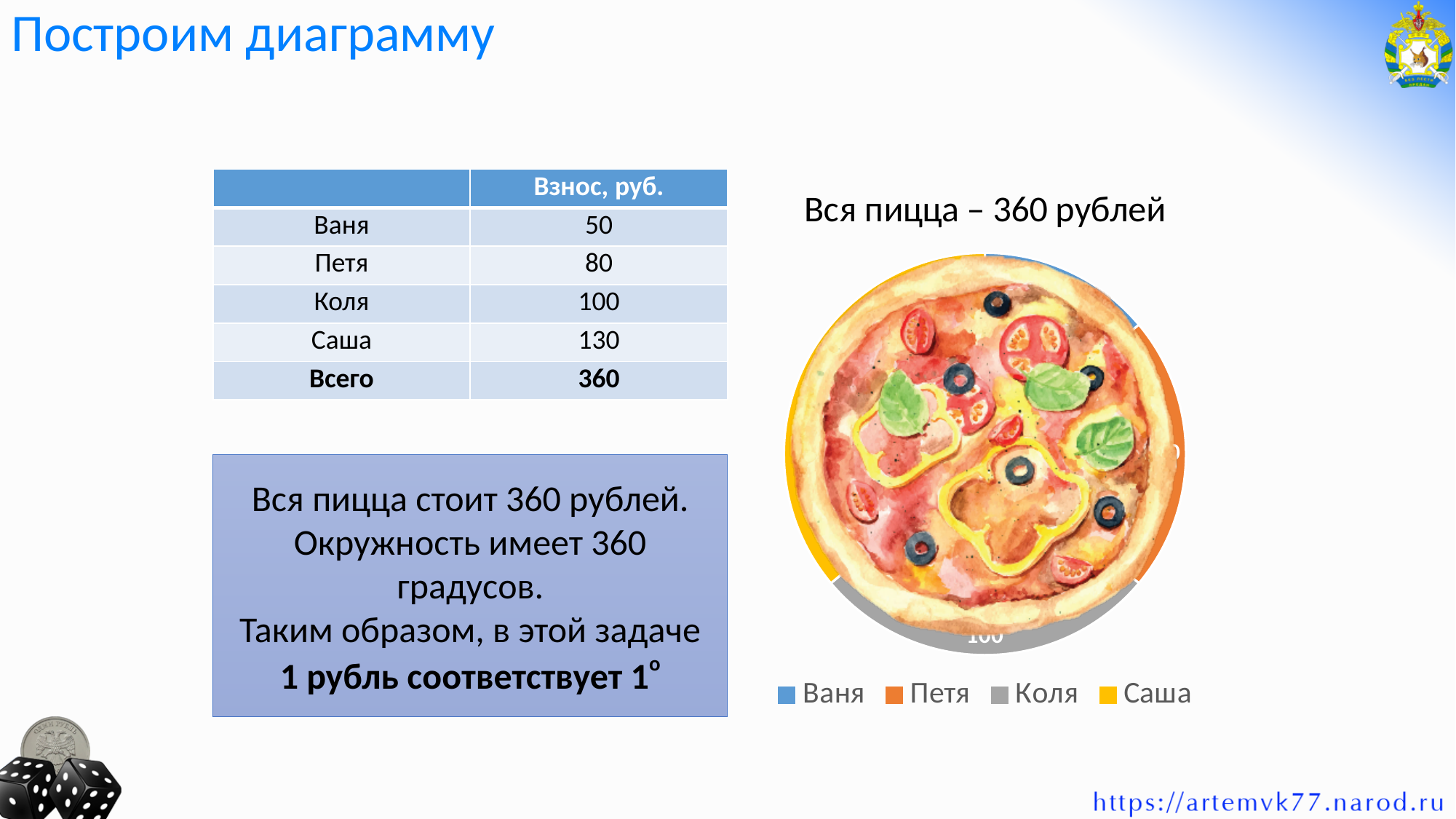
Which person has the smallest slice of the pie chart? Ваня How many entries does the legend of the pie chart list? 4 What is the contribution (взнос) of Саша shown on the slide? 130 What is the total value represented by the whole pie chart? 360 What is the title of the pie chart? Вся пицца – 360 рублей Which colour represents Саша in the pie chart? yellow What is the contribution (взнос) of Коля shown on the slide? 100 Whose slice is larger in the pie chart, Петя's or Ваня's? Петя Which person has the largest slice of the pie chart? Саша What kind of chart is shown on the slide? pie chart How many slices does the pie chart have? 4 What is the difference between Саша's and Ваня's contributions? 80